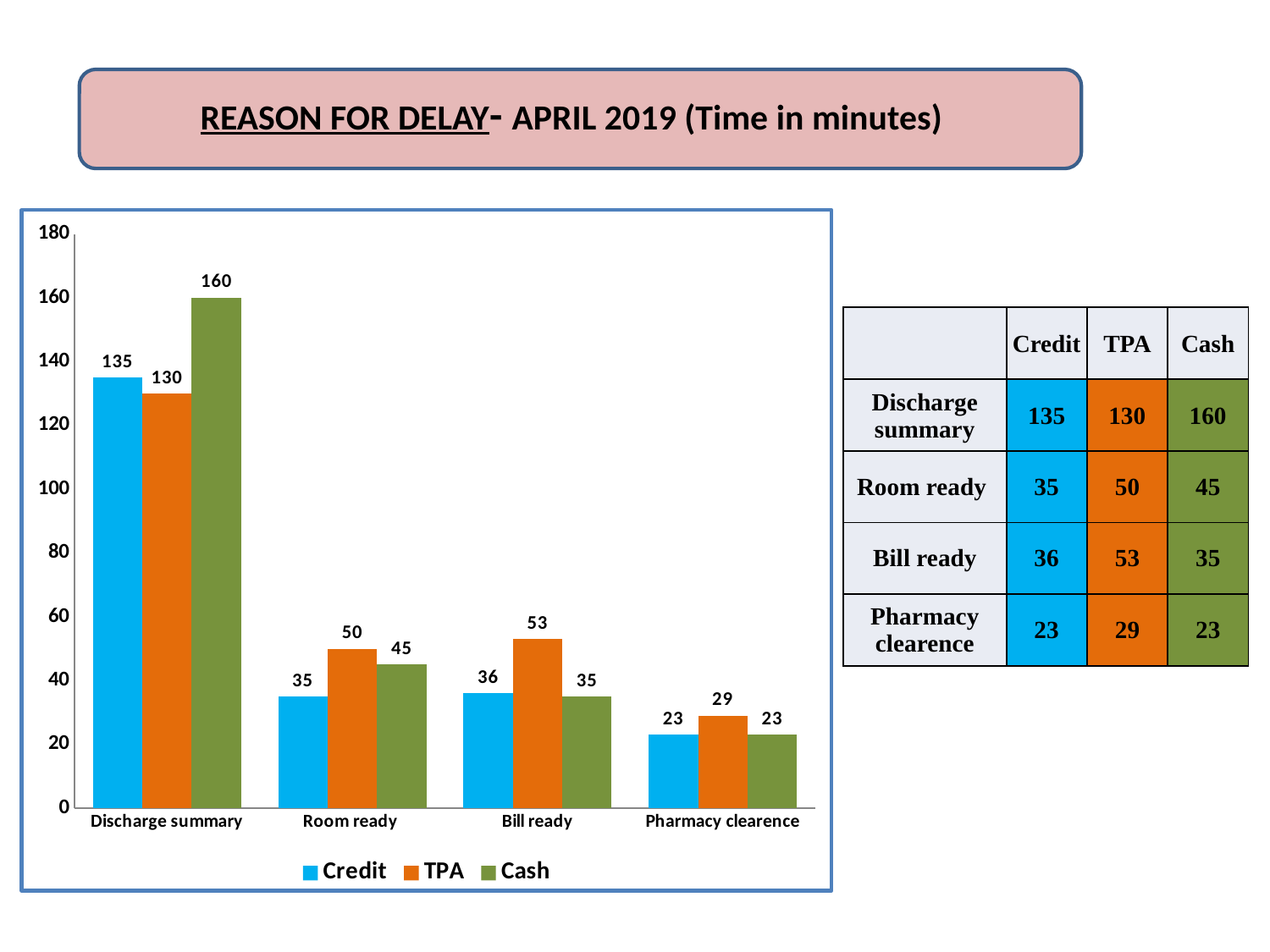
How many series does the legend list? 3 What is the Cash value for Discharge summary? 160 Which category has the lowest Cash value? Pharmacy clearence What kind of chart is shown on the slide? Bar chart Which series is shown in orange in the legend? TPA How many categories are shown on the x axis? 4 What is the difference between the Cash and Credit values for Discharge summary? 25 What is the TPA value for Bill ready? 53 Which category has the highest TPA value? Discharge summary Which is larger for Bill ready, the TPA value or the Cash value? TPA What is the Credit value for Pharmacy clearence? 23 What is the difference between the TPA and Credit values for Room ready? 15